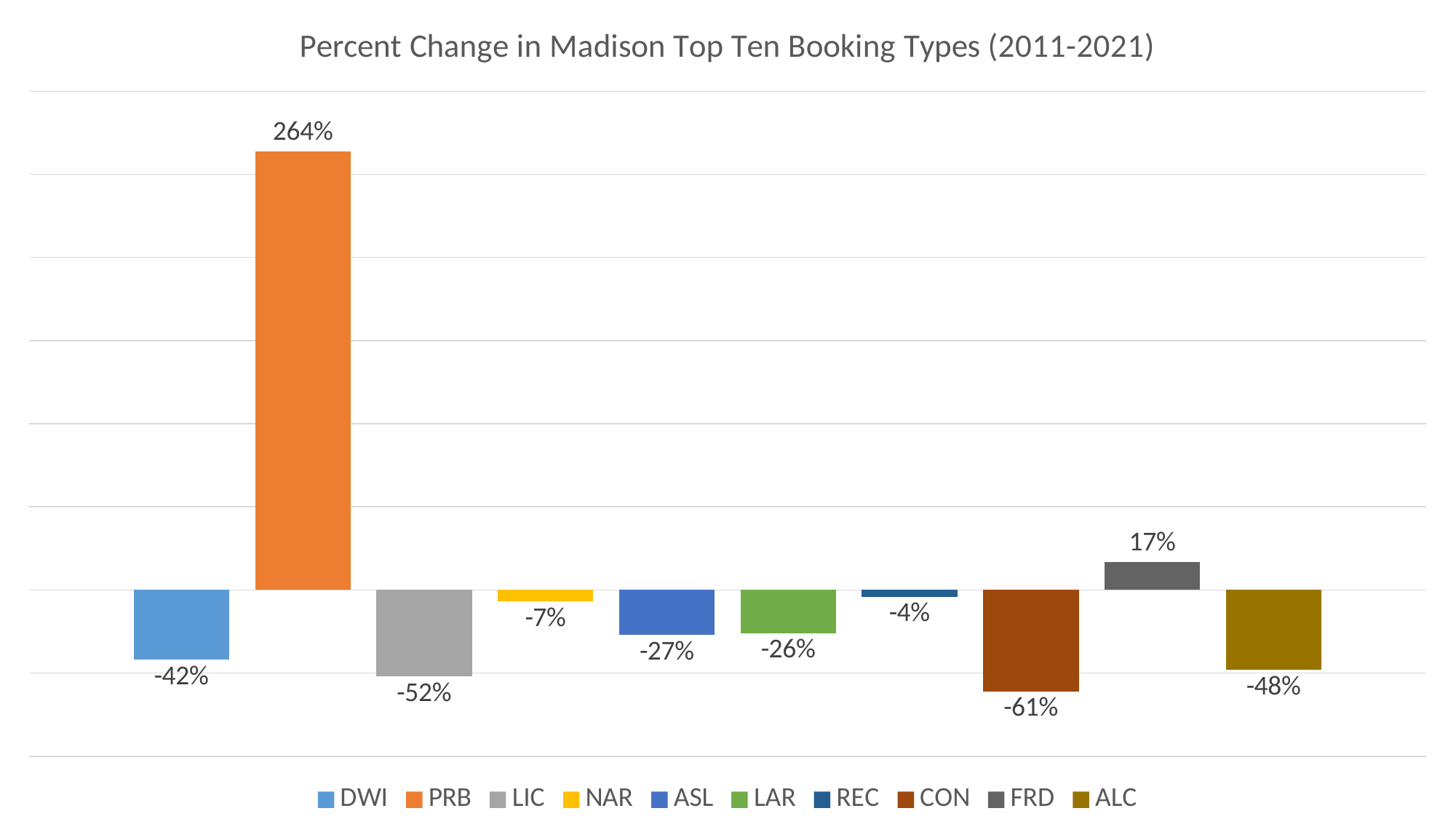
What is the percent change for NAR? -7% How many entries does the legend list? 10 Which booking type has the lowest percent change? CON What is the title of the chart? Percent Change in Madison Top Ten Booking Types (2011-2021) What is the percent change for PRB? 264% Which booking type has the highest percent change? PRB What is the percent change for FRD? 17% How many booking types are shown in the chart? 10 What kind of chart is shown on the slide? Bar chart What is the difference between the percent change for DWI and the percent change for LIC? 10 percentage points What is the percent change for CON? -61% Which has a larger percent change, ASL or REC? REC